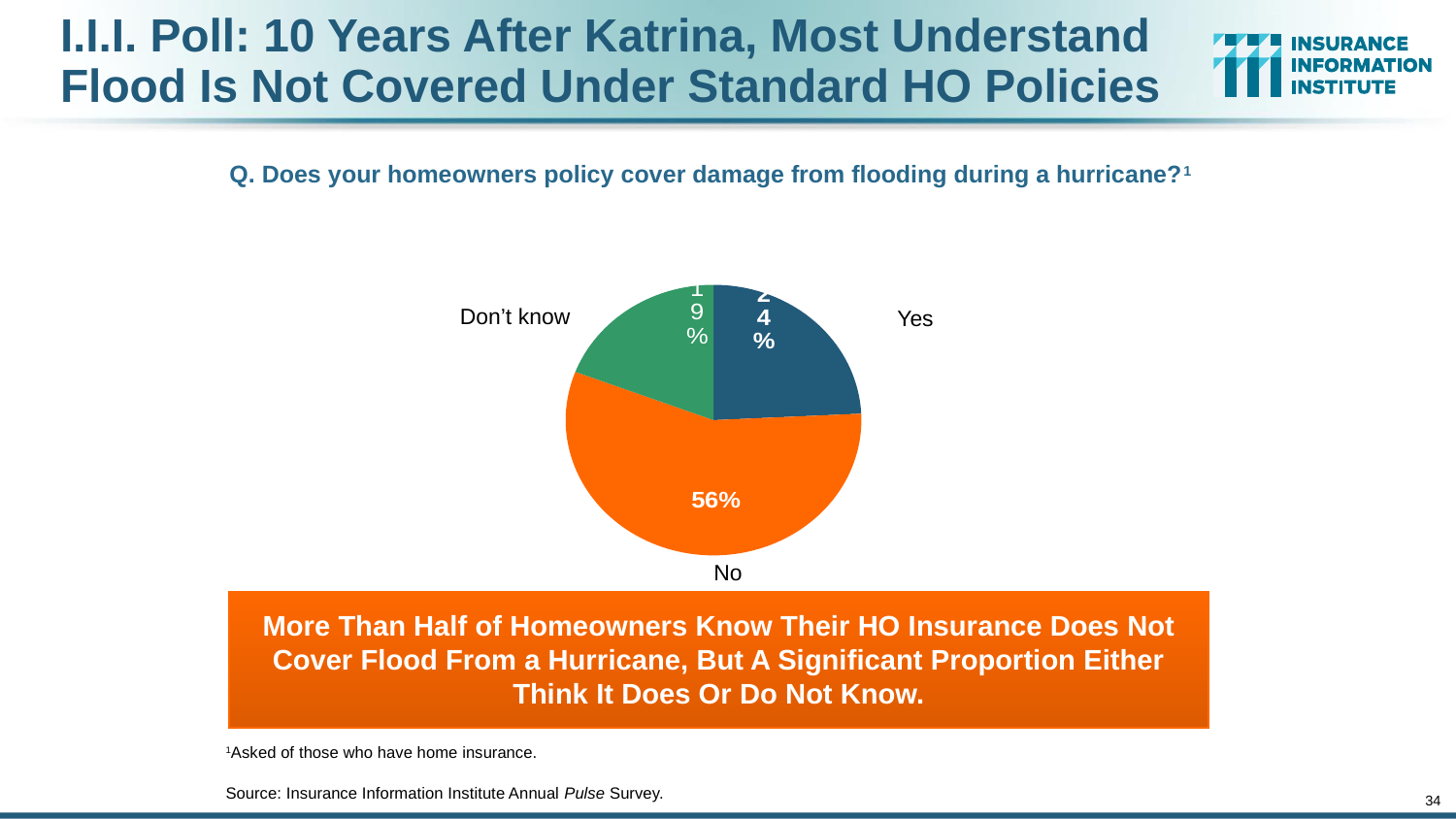
What kind of chart is shown on the slide? pie chart How many slices does the pie chart have? 3 Which response has the smallest share of the pie? Don't know What share of respondents answered "Don't know"? 19% Which response has the largest share of the pie? No What colour is the "No" slice of the pie? orange What share of respondents answered "Yes"? 24% Is the share for "No" greater or less than 50%? greater What share of respondents answered "No"? 56% What is the difference between the "No" share and the "Yes" share? 32% What question does the pie chart report responses to? Does your homeowners policy cover damage from flooding during a hurricane? Which is larger, the share for "Yes" or the share for "Don't know"? Yes